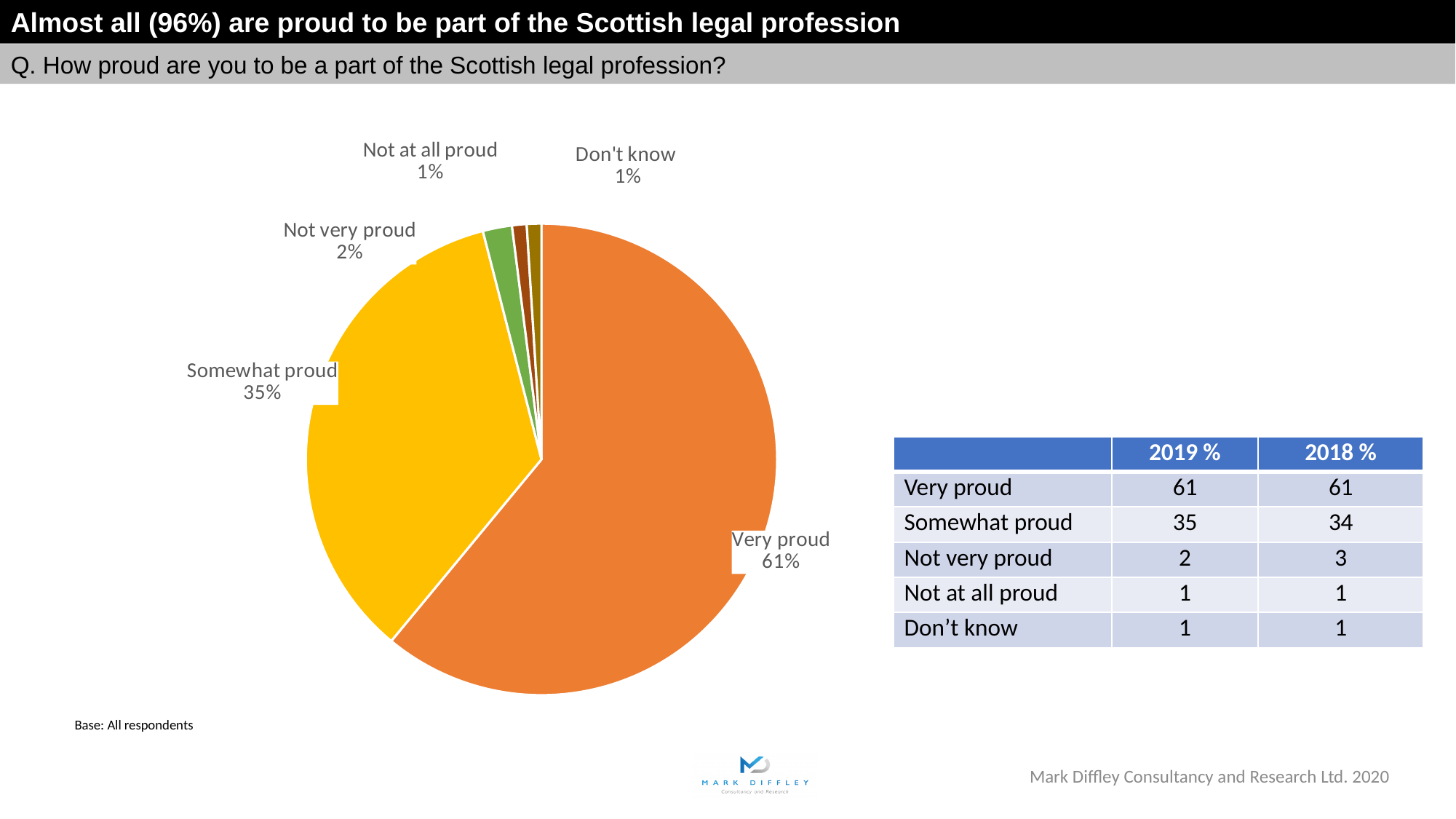
What colour is the 'Somewhat proud' slice? yellow How many slices does the pie chart have? 5 What is the value for 'Not very proud' in the pie chart? 2% What is the combined share of 'Very proud' and 'Somewhat proud'? 96% What is the value for 'Somewhat proud' in the pie chart? 35% What kind of chart is shown on the slide? pie chart Which category has the largest slice of the pie? Very proud What share of the pie is 'Very proud'? 61% What is the difference between the 'Very proud' and 'Somewhat proud' slices? 26% What question does the chart report responses to? How proud are you to be a part of the Scottish legal profession? Which is larger in the pie chart, 'Not very proud' or 'Not at all proud'? Not very proud What is the value for 'Don't know' in the pie chart? 1%